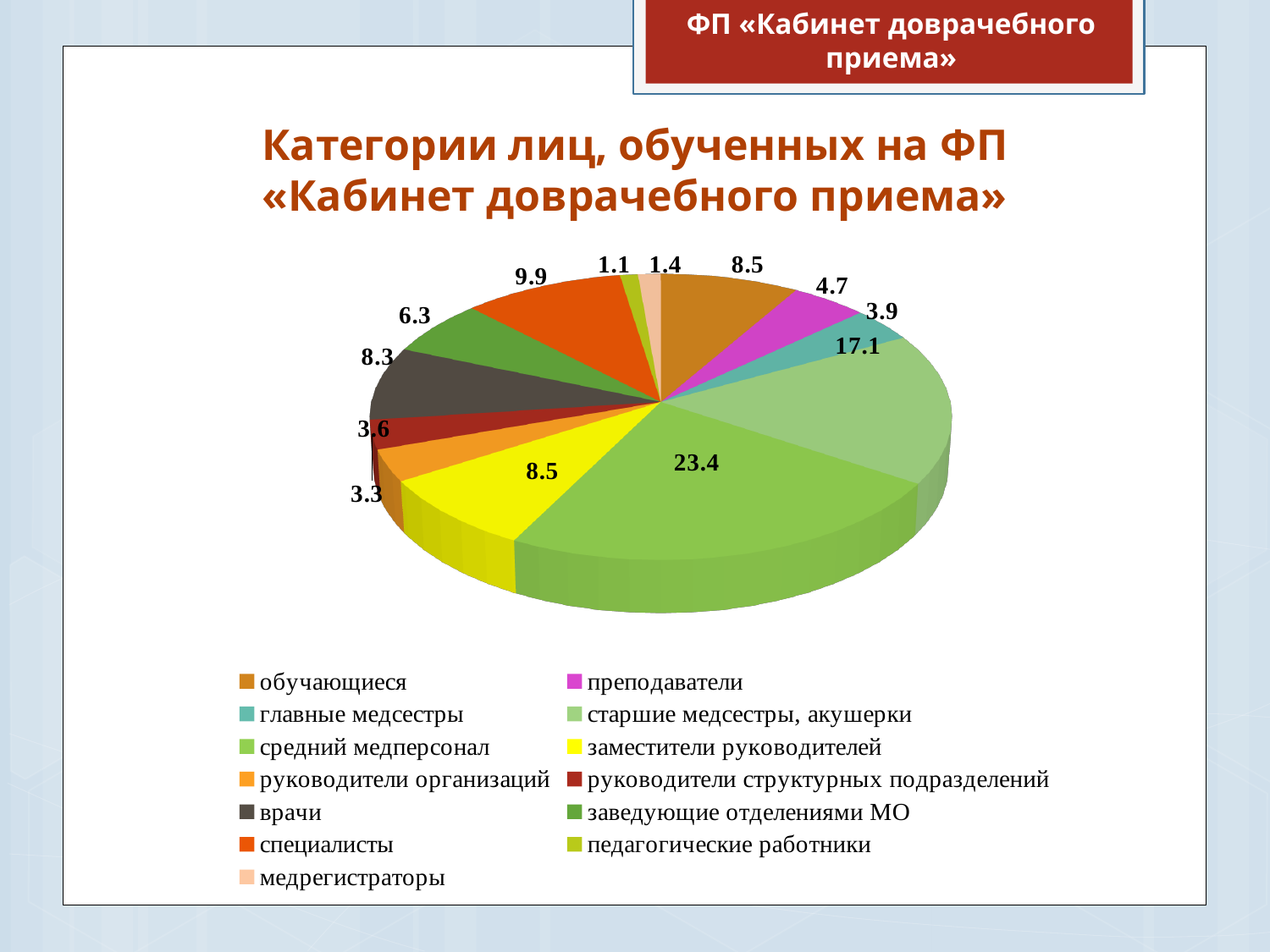
Which is larger, the value for специалисты or the value for врачи? специалисты Which category has the smallest share of the pie? педагогические работники What is the difference between the values for средний медперсонал and старшие медсестры, акушерки? 6.3 What is the value shown for врачи? 8.3 What is the value shown for заведующие отделениями МО? 6.3 Which category has the largest share of the pie? средний медперсонал What is the value shown for преподаватели? 4.7 What kind of chart is shown on the slide? pie chart How many categories does the legend list? 13 What is the title of the chart? Категории лиц, обученных на ФП «Кабинет доврачебного приема» What is the value shown for старшие медсестры, акушерки? 17.1 What is the value shown for специалисты? 9.9